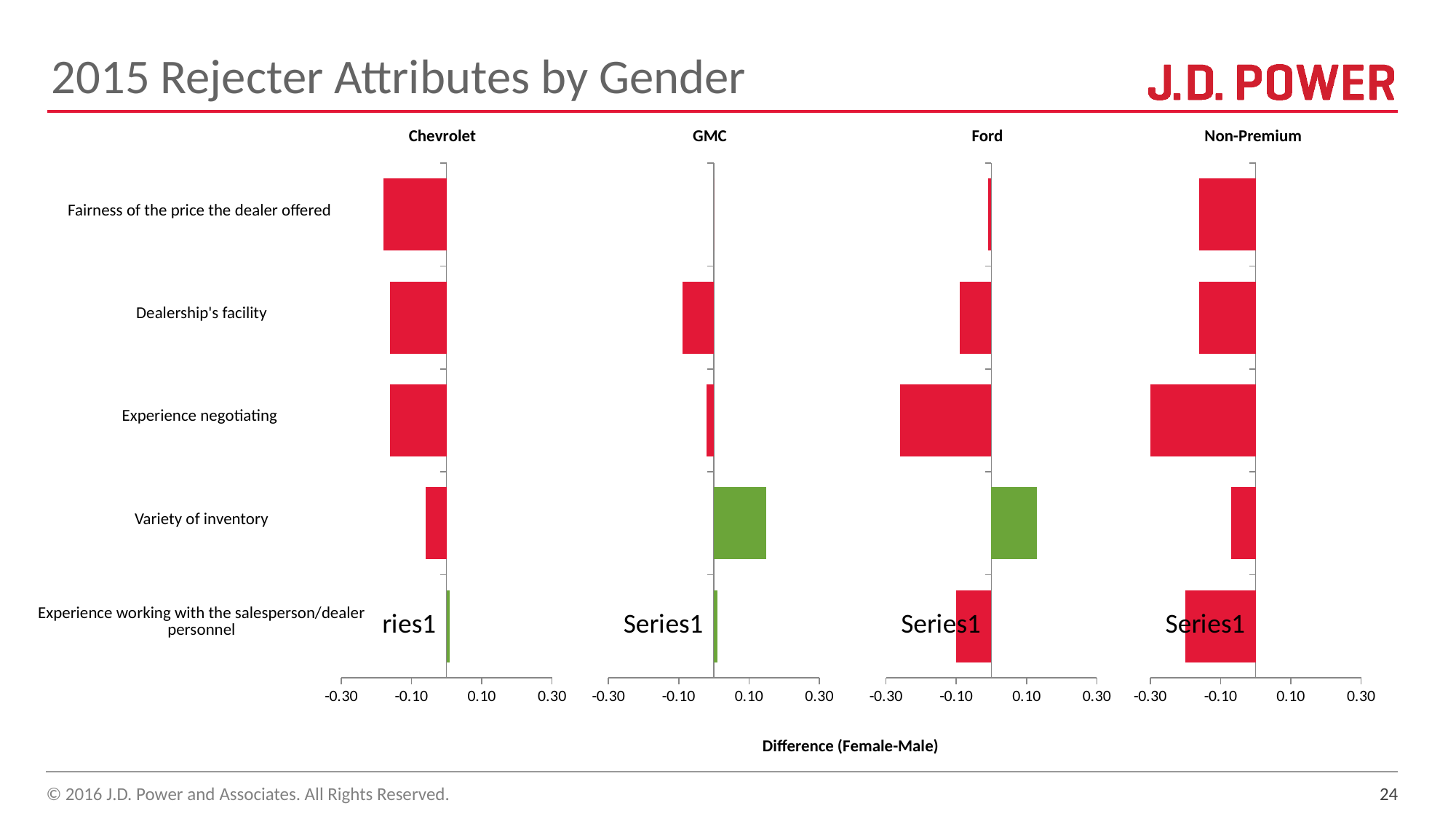
In the Chevrolet chart, which is larger, the value for Variety of inventory or the value for Fairness of the price the dealer offered? Variety of inventory In the GMC chart, which attribute has the highest value? Variety of inventory What kind of chart is used for the Chevrolet panel? bar chart In the Ford chart, which attribute has the highest value? Variety of inventory In the Non-Premium chart, which attribute has the lowest (most negative) value? Experience negotiating In the GMC chart, is the value for Variety of inventory greater or less than 0.10? greater How many separate charts (brand panels) are shown on the slide? 4 In the Chevrolet chart, is the value for Fairness of the price the dealer offered greater or less than -0.10? less In the Ford chart, is the value for Experience negotiating greater or less than -0.10? less How many attribute categories are listed on the y axis of the charts? 5 In the Ford chart, which attribute has the lowest (most negative) value? Experience negotiating What is the x-axis title shared by the charts? Difference (Female-Male)